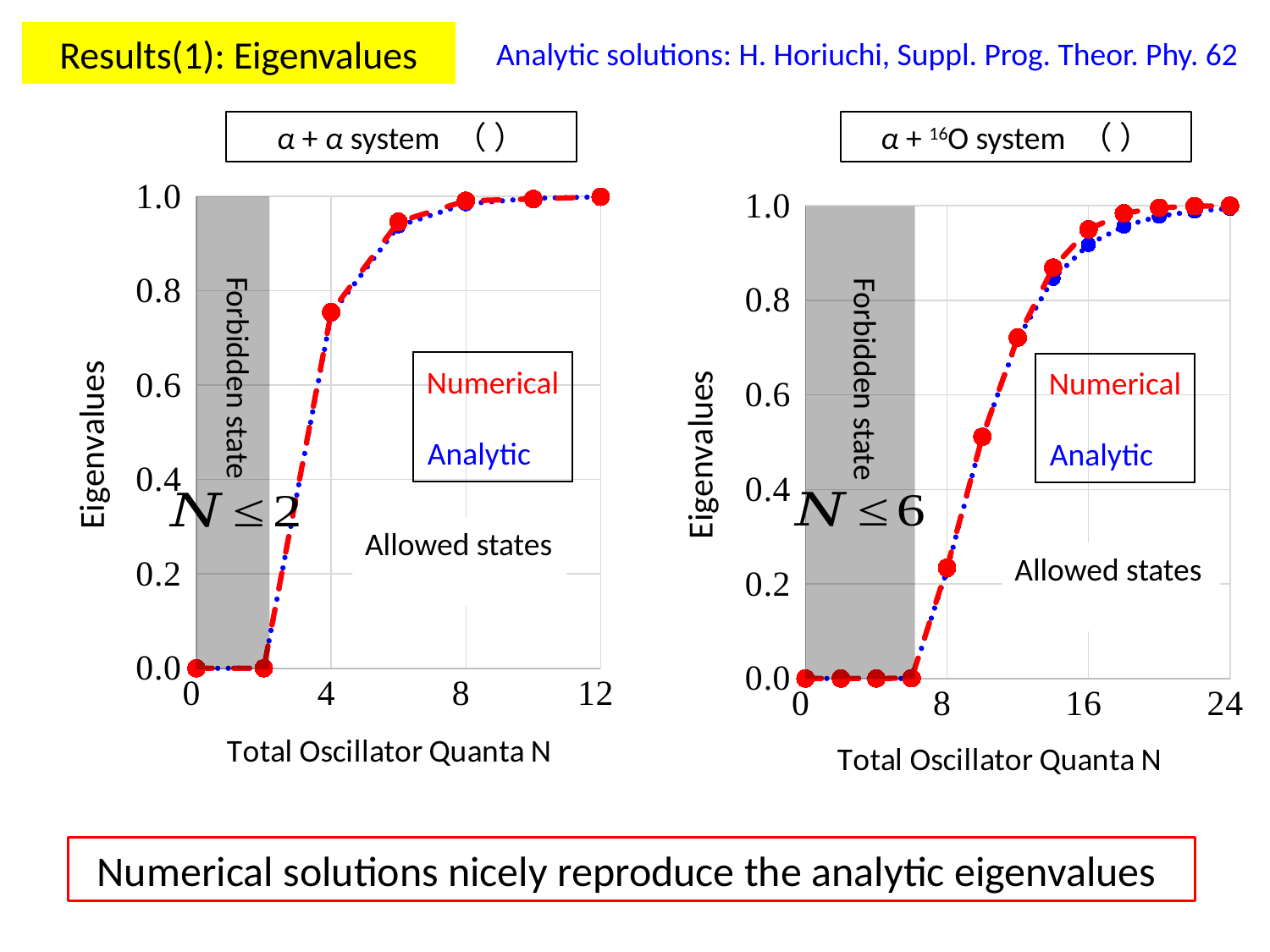
In the α + α system chart, is the eigenvalue at N = 4 greater or less than 0.8? less In the α + α system chart, how many red Numerical data points are plotted? 7 In the α + 16O system chart, is the eigenvalue at N = 12 greater or less than 0.6? greater In the α + α system chart, what is the eigenvalue at N = 2? 0.0 In the α + α system chart, which has the larger eigenvalue, N = 4 or N = 6? N = 6 In the α + 16O system chart, is the eigenvalue at N = 8 greater or less than 0.4? less In the α + 16O system chart, what is the label of the x axis? Total Oscillator Quanta N What kind of chart is the α + α system chart on the left? line chart In the α + α system chart, how many series does the legend list? 2 In the α + 16O system chart, which has the larger eigenvalue, N = 8 or N = 12? N = 12 In the α + 16O system chart, do the eigenvalues rise or fall as N increases from 6 to 24? rise